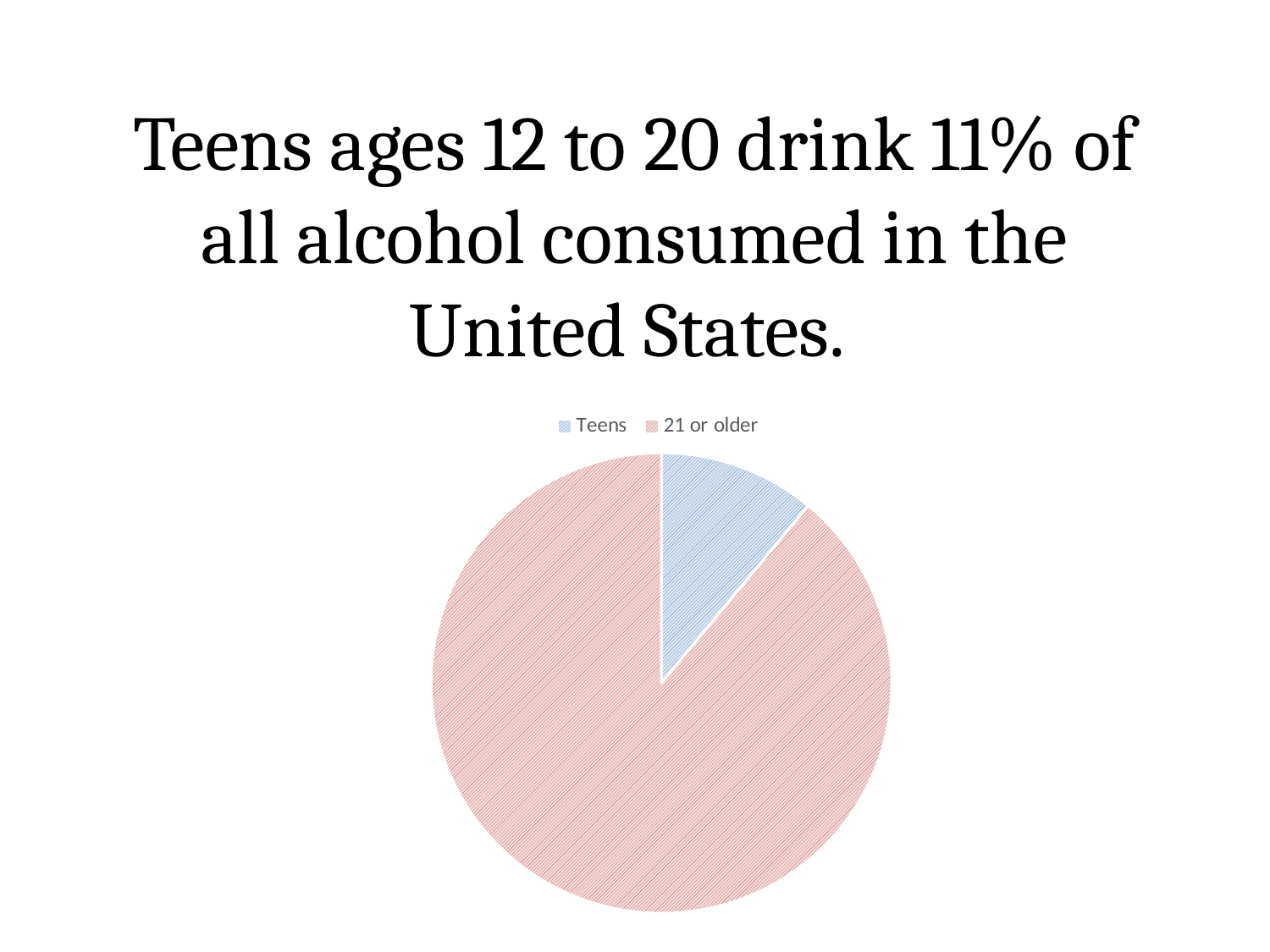
Which slice of the pie chart is the smallest? Teens What kind of chart is shown on the slide? pie chart How many slices does the pie chart have? 2 Which slice of the pie chart is the largest? 21 or older Which slice is larger in the pie chart, Teens or 21 or older? 21 or older According to the slide, what share of all alcohol consumed in the United States is drunk by teens? 11% What colour is the Teens slice in the pie chart? blue What are the two legend entries of the pie chart? Teens, 21 or older How many entries does the legend of the pie chart list? 2